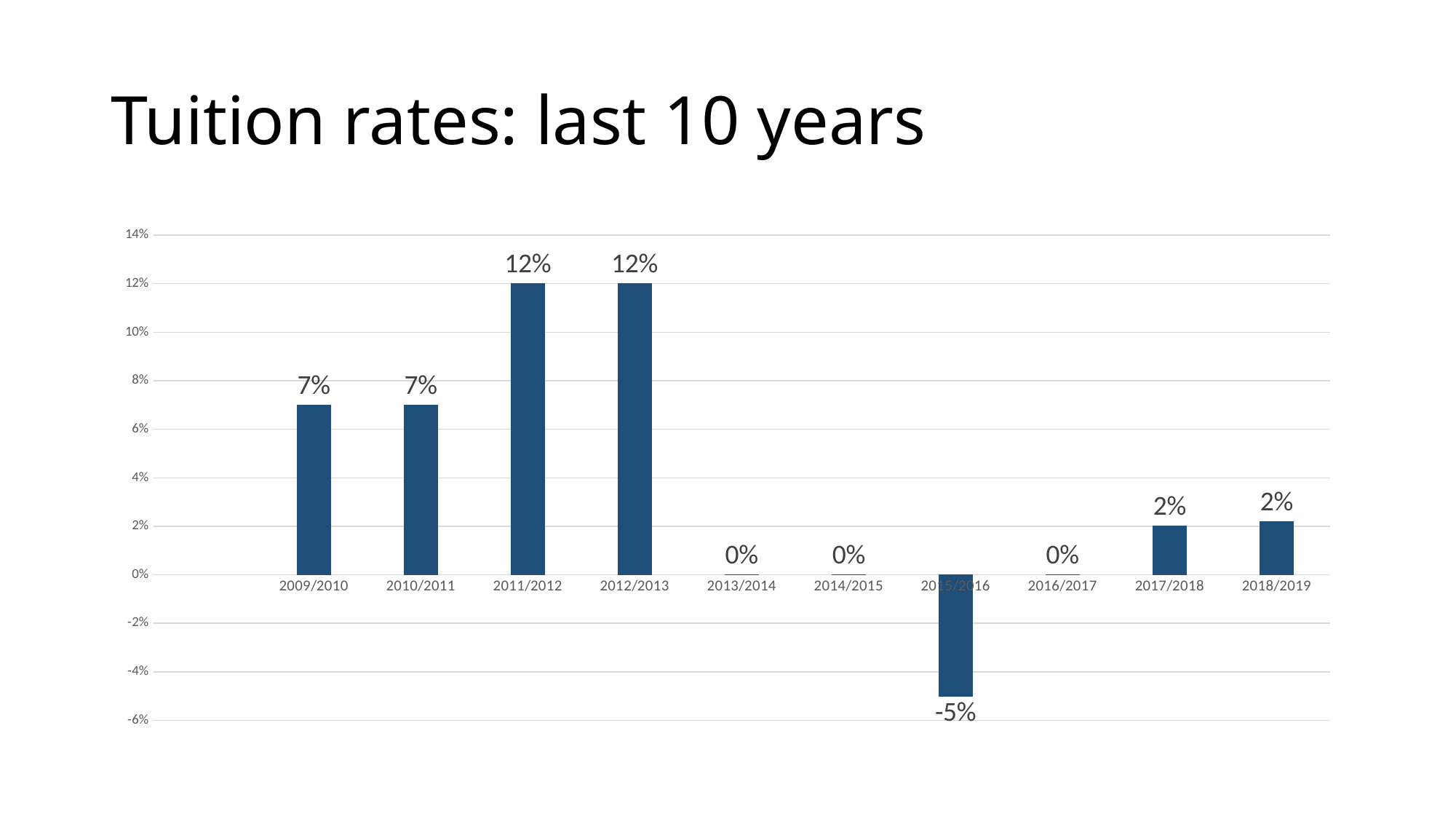
What is the difference between the tuition rate change in 2012/2013 and in 2017/2018? 10% What is the tuition rate change for 2015/2016? -5% How many years are shown on the x axis? 10 How many years show a tuition rate change of 0%? 3 What kind of chart is shown on the slide? Bar chart What is the tuition rate change for 2011/2012? 12% Is the value for 2015/2016 greater or less than -2%? less What is the title of the slide? Tuition rates: last 10 years What is the tuition rate change for 2009/2010? 7% Which year has the lowest tuition rate change? 2015/2016 What is the tuition rate change for 2018/2019? 2% Which is larger, the tuition rate change for 2010/2011 or for 2017/2018? 2010/2011